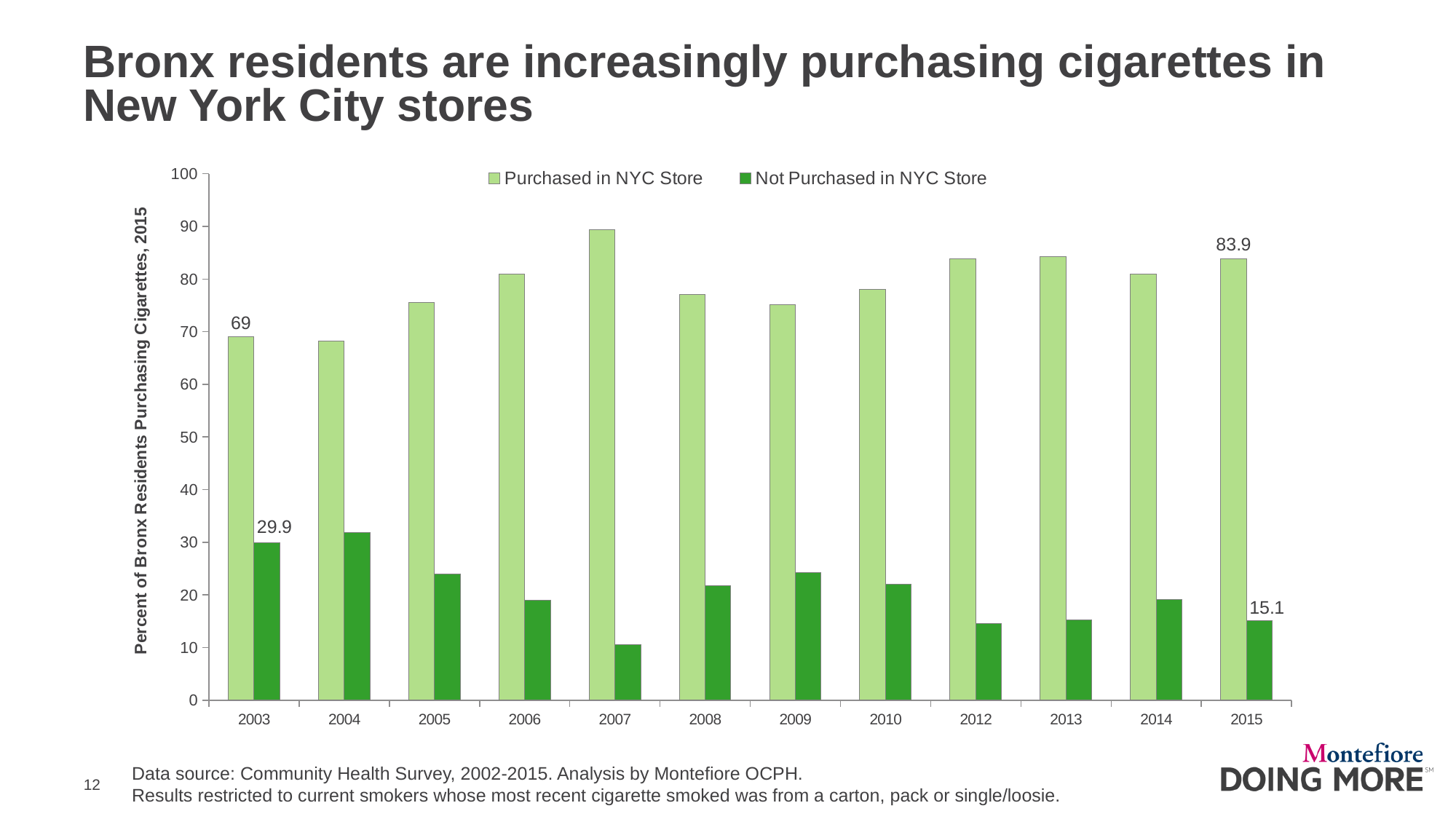
What is the value for Purchased in NYC Store in 2003? 69 In which year is the Not Purchased in NYC Store value lowest? 2007 How many series does the legend list? 2 What kind of chart is shown on the slide? bar chart Which is larger in 2015: Purchased in NYC Store or Not Purchased in NYC Store? Purchased in NYC Store Is the value for Not Purchased in NYC Store in 2012 greater or less than 20? less Is the value for Purchased in NYC Store in 2007 greater or less than 80? greater How many years are shown on the x axis? 12 In which year is the Purchased in NYC Store value highest? 2007 What is the value for Not Purchased in NYC Store in 2015? 15.1 How much higher is the Purchased in NYC Store value in 2015 than in 2003? 14.9 What is the value for Not Purchased in NYC Store in 2003? 29.9